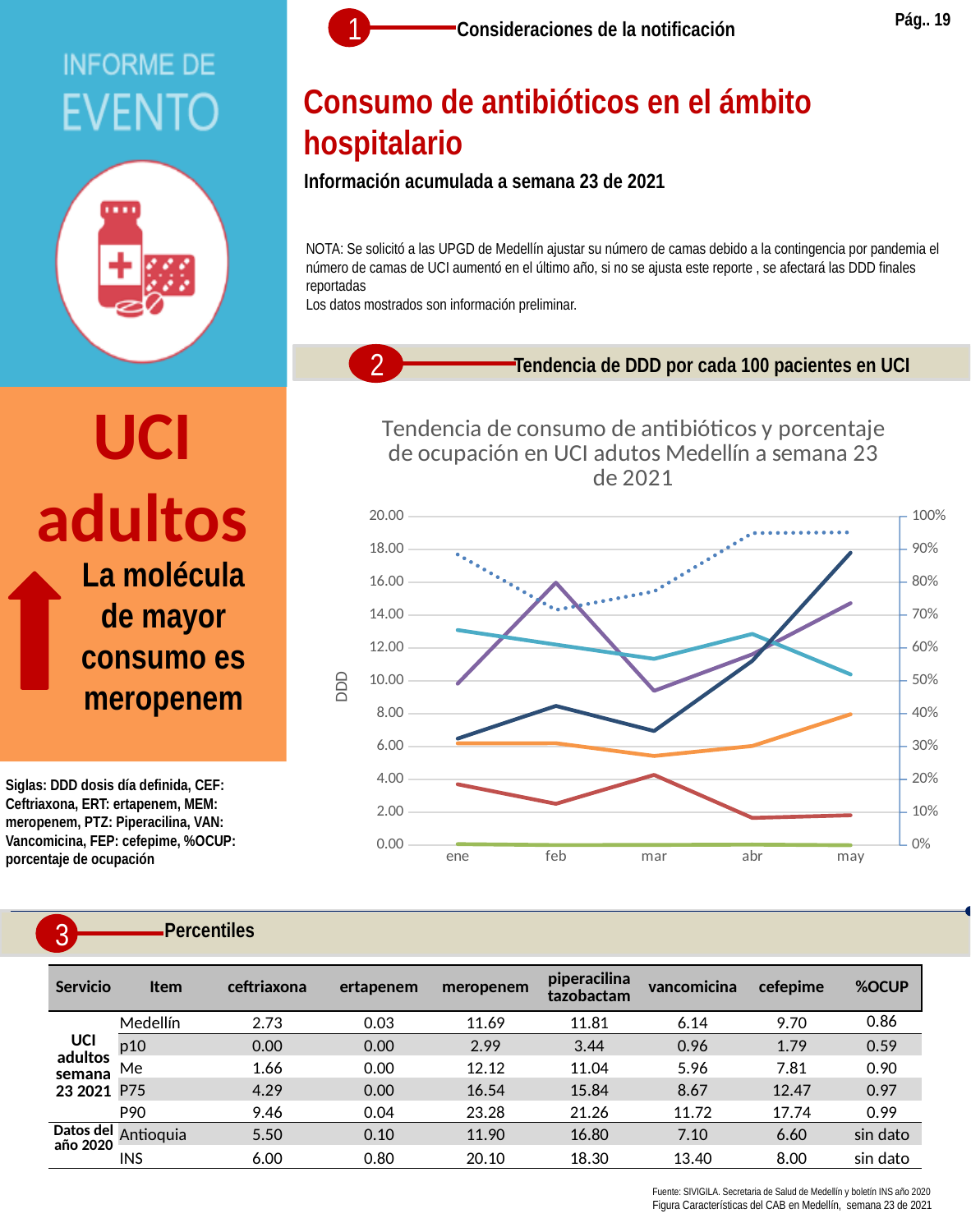
Is the value of the dotted line in may greater or less than 90%? greater Is the value of the green line in ene greater or less than 2.00? less Is the value of the purple line in feb greater or less than 14.00? greater What is the title of the chart? Tendencia de consumo de antibióticos y porcentaje de ocupación en UCI adutos Medellín a semana 23 de 2021 What kind of chart is shown on the slide? line chart What is the label of the left vertical axis of the chart? DDD Does the orange line rise or fall from mar to may? rise Does the light blue line rise or fall from abr to may? fall How many months are shown along the x axis of the chart? 5 Does the dark blue line rise or fall from mar to may? rise